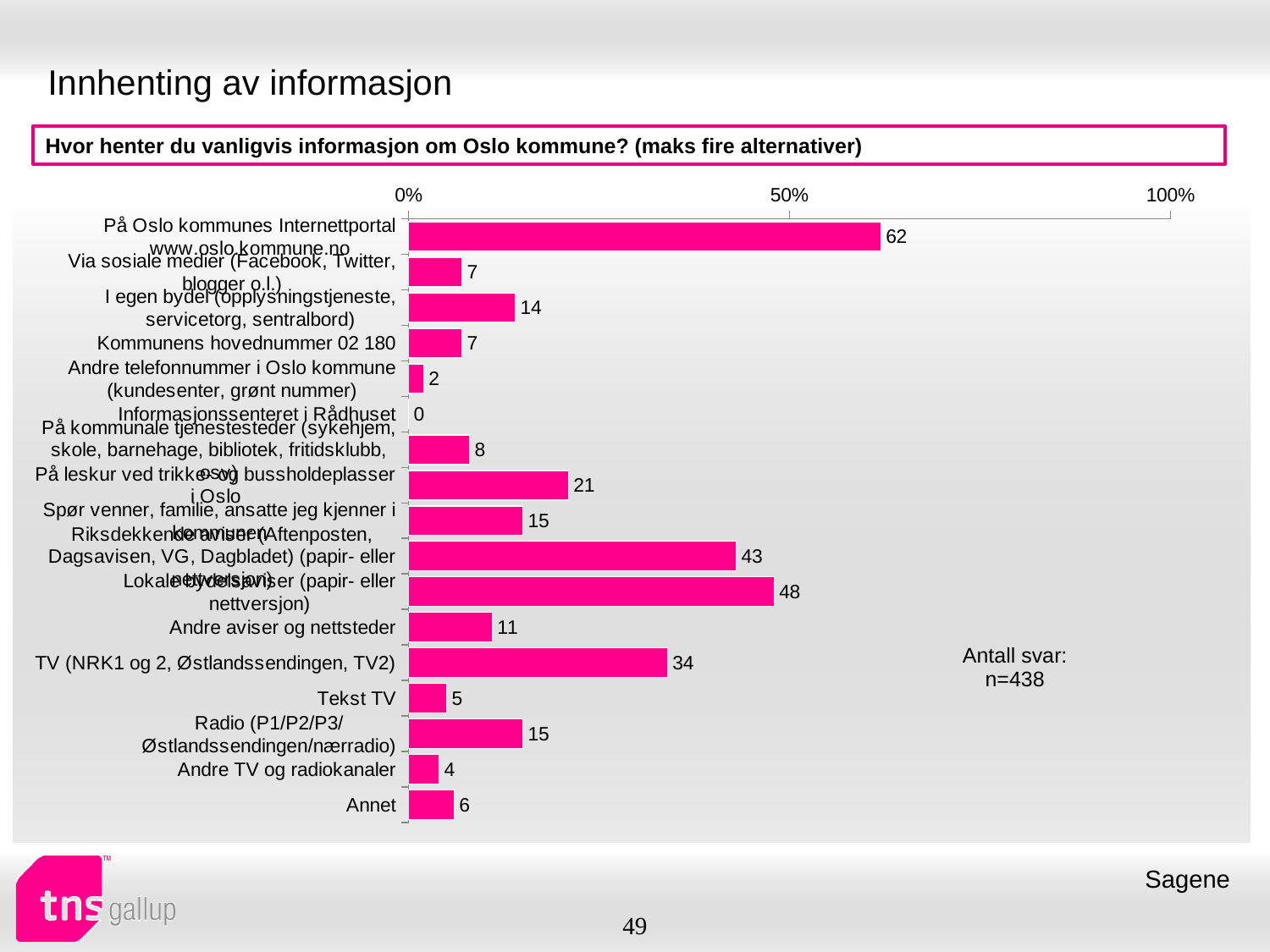
What is the value for "Tekst TV"? 5 What is the difference between the values for "Lokale bydelsaviser (papir- eller nettversjon)" and "Riksdekkende aviser"? 5 Which category has the lowest value? Informasjonssenteret i Rådhuset What kind of chart is shown on the slide? bar chart What is the value for "Kommunens hovednummer 02 180"? 7 Which is larger: the value for "Annet" or the value for "Andre TV og radiokanaler"? Annet What is the value for "TV (NRK1 og 2, Østlandssendingen, TV2)"? 34 How many categories are shown in the chart? 17 Is the value for "På Oslo kommunes Internettportal www.oslo.kommune.no" greater or less than 50%? greater Which category has the highest value? På Oslo kommunes Internettportal www.oslo.kommune.no What is the value for "Andre aviser og nettsteder"? 11 What is the number of respondents (Antall svar) shown on the slide? n=438